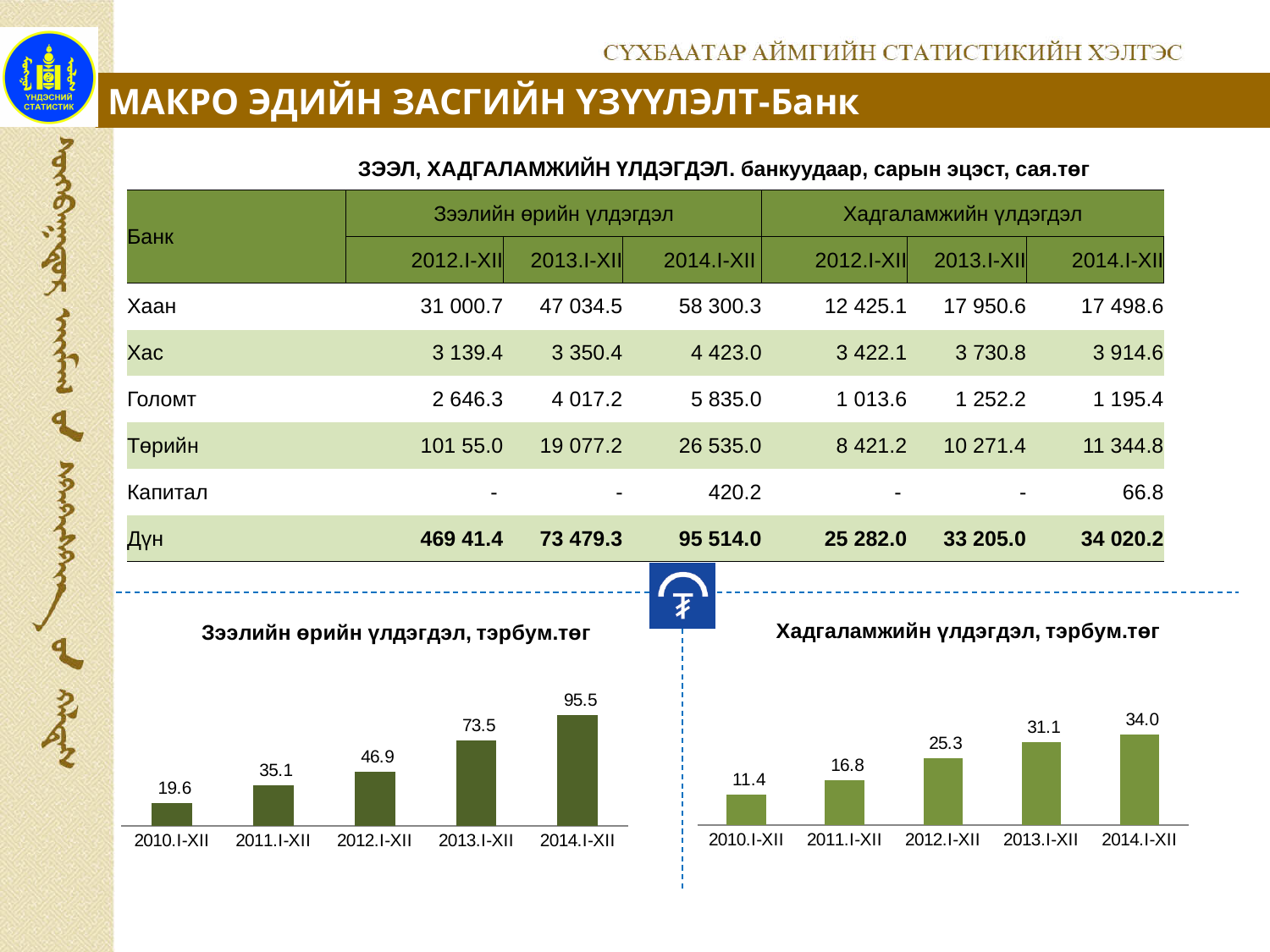
How many bars are shown in the chart titled 'Хадгаламжийн үлдэгдэл, тэрбум.төг'? 5 In the chart titled 'Зээлийн өрийн үлдэгдэл, тэрбум.төг', what is the value for 2011.I-XII? 35.1 In the chart titled 'Хадгаламжийн үлдэгдэл, тэрбум.төг', what is the difference between the values for 2011.I-XII and 2010.I-XII? 5.4 In the chart titled 'Хадгаламжийн үлдэгдэл, тэрбум.төг', which period has the highest value? 2014.I-XII In the chart titled 'Зээлийн өрийн үлдэгдэл, тэрбум.төг', what is the difference between the values for 2014.I-XII and 2013.I-XII? 22.0 In the chart titled 'Хадгаламжийн үлдэгдэл, тэрбум.төг', do the values rise or fall from 2010.I-XII to 2014.I-XII? Rise In the chart titled 'Зээлийн өрийн үлдэгдэл, тэрбум.төг', which is larger: the value for 2012.I-XII or 2011.I-XII? 2012.I-XII In the chart titled 'Хадгаламжийн үлдэгдэл, тэрбум.төг', what is the value for 2012.I-XII? 25.3 In the chart titled 'Зээлийн өрийн үлдэгдэл, тэрбум.төг', which period has the lowest value? 2010.I-XII What is the title of the bar chart on the right side of the slide? Хадгаламжийн үлдэгдэл, тэрбум.төг What type of chart is the chart titled 'Зээлийн өрийн үлдэгдэл, тэрбум.төг'? Bar chart In the chart titled 'Зээлийн өрийн үлдэгдэл, тэрбум.төг', what is the value for 2014.I-XII? 95.5